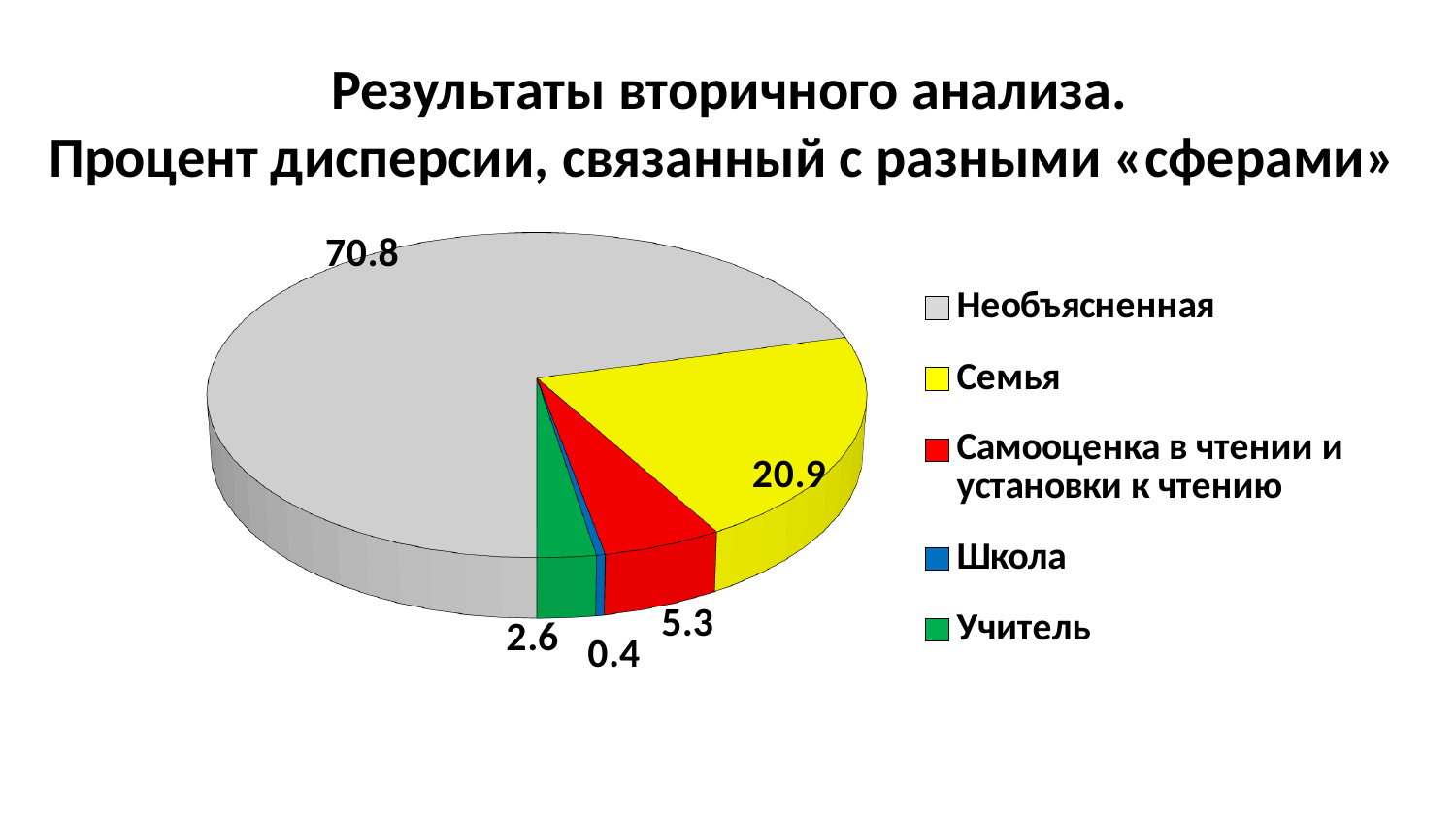
Which is larger, the value for Учитель or the value for Школа? Учитель What value is shown for the Семья slice? 20.9 What value is shown for the slice labelled Самооценка в чтении и установки к чтению? 5.3 What value is shown for the Школа slice? 0.4 What is the difference between the values for Необъясненная and Семья? 49.9 What value is shown for the Необъясненная slice? 70.8 Which category has the smallest slice of the pie? Школа How many categories does the legend list? 5 Which category has the largest slice of the pie? Необъясненная What value is shown for the Учитель slice? 2.6 What kind of chart is shown on the slide? Pie chart What is the difference between the values for Самооценка в чтении и установки к чтению and Учитель? 2.7